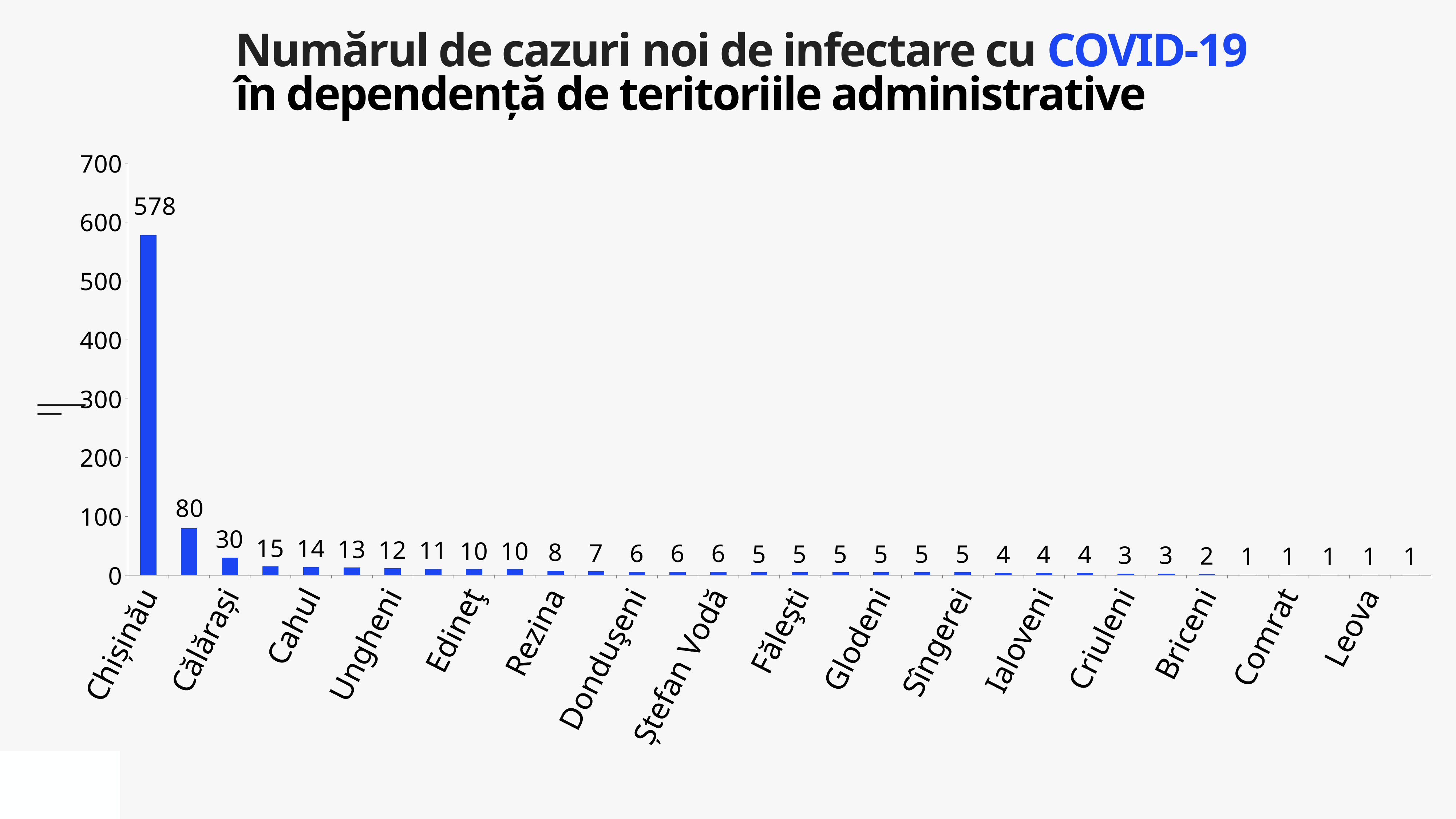
Which administrative territory has the highest number of new cases? Chișinău What is the lowest value shown on the chart? 1 What is the value for Dondușeni? 6 What is the value for Chișinău? 578 What is the highest value shown on the chart? 578 Do the values rise or fall from left to right along the x axis? fall What kind of chart is shown on the slide? bar chart What is the difference between the highest bar (578) and the second-highest bar (80)? 498 How many bars are plotted on the chart? 32 What is the value for Leova? 1 Is the value for Chișinău greater or less than 500? greater What is the value for Fălești? 5